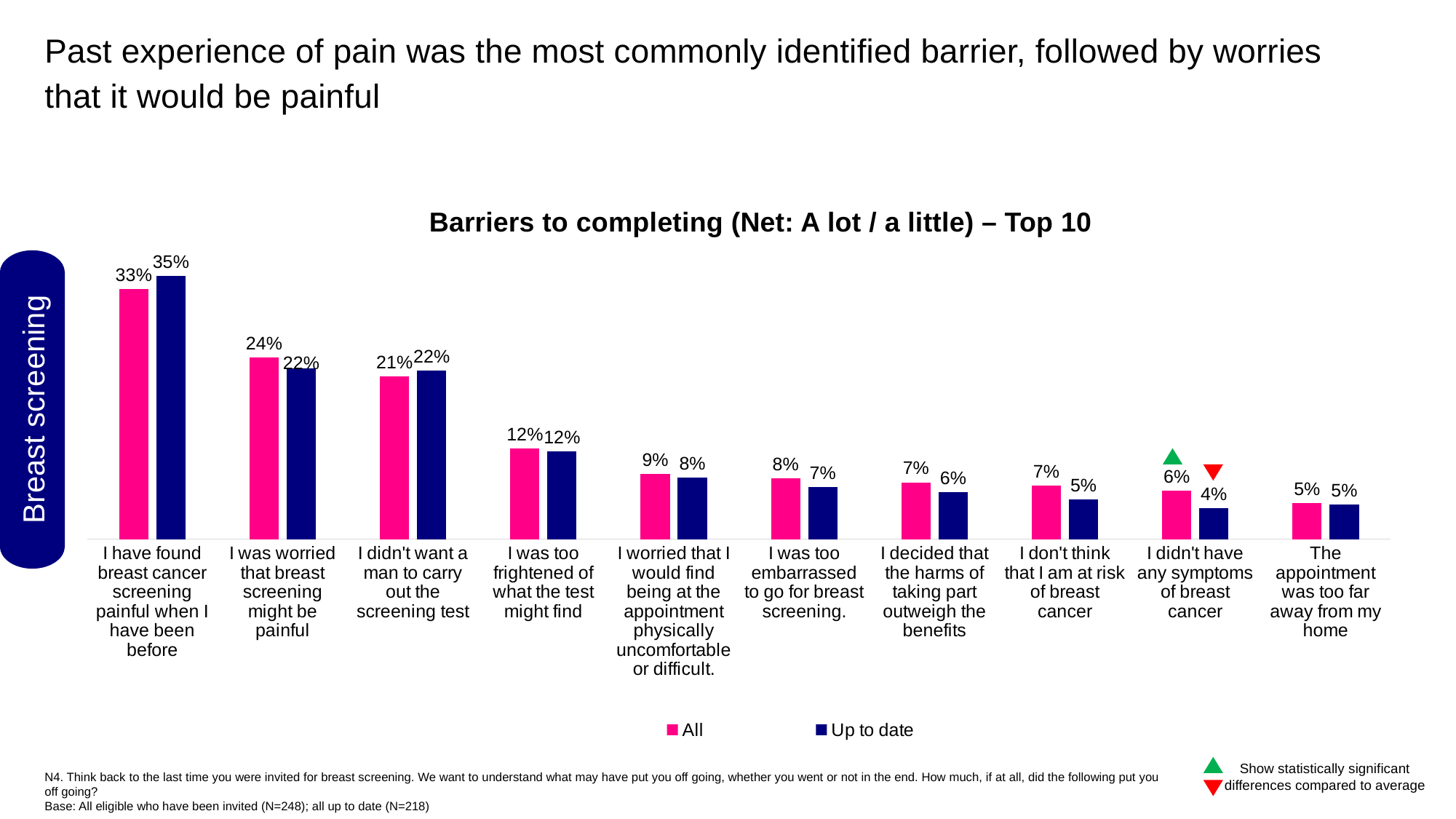
Which category has the lowest 'Up to date' value? I didn't have any symptoms of breast cancer What kind of chart is shown on the slide? Bar chart What is the value for 'Up to date' for 'I was worried that breast screening might be painful'? 22% What is the value for 'All' for 'I have found breast cancer screening painful when I have been before'? 33% How many series does the legend list? 2 Do the 'All' values generally rise or fall from left to right along the x axis? Fall How many categories are shown on the x axis? 10 What is the difference between the 'All' and 'Up to date' values for 'I have found breast cancer screening painful when I have been before'? 2% What is the value for 'All' for 'I didn't want a man to carry out the screening test'? 21% What is the title of the chart? Barriers to completing (Net: A lot / a little) – Top 10 Which category has the highest 'Up to date' value? I have found breast cancer screening painful when I have been before Which is larger for 'I was worried that breast screening might be painful': the 'All' value or the 'Up to date' value? All